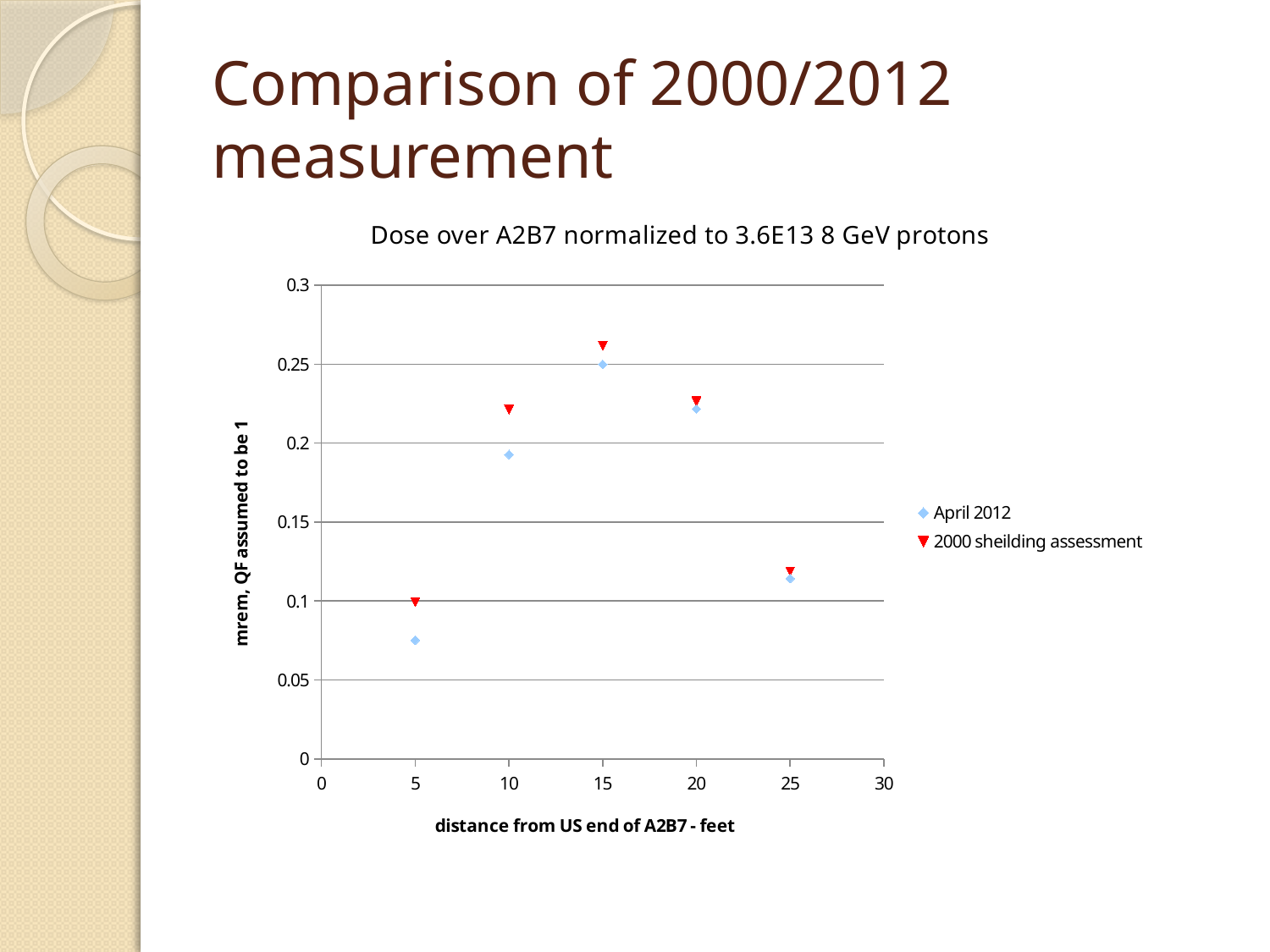
At which distance from the US end of A2B7 is the April 2012 dose lowest? 5 feet Is the April 2012 value at 10 feet greater or less than 0.2? less At 5 feet, which series shows the higher dose, April 2012 or the 2000 shielding assessment? 2000 shielding assessment At which distance is the 2000 shielding assessment dose lowest? 5 feet What is the title of the chart? Dose over A2B7 normalized to 3.6E13 8 GeV protons Is the April 2012 value at 5 feet greater or less than 0.1? less How many series does the legend list? 2 What kind of chart is shown on the slide? Scatter chart At which distance from the US end of A2B7 is the April 2012 dose highest? 15 feet Is the 2000 shielding assessment value at 15 feet greater or less than 0.25? greater At which distance is the 2000 shielding assessment dose highest? 15 feet How many data points are plotted for the April 2012 series? 5